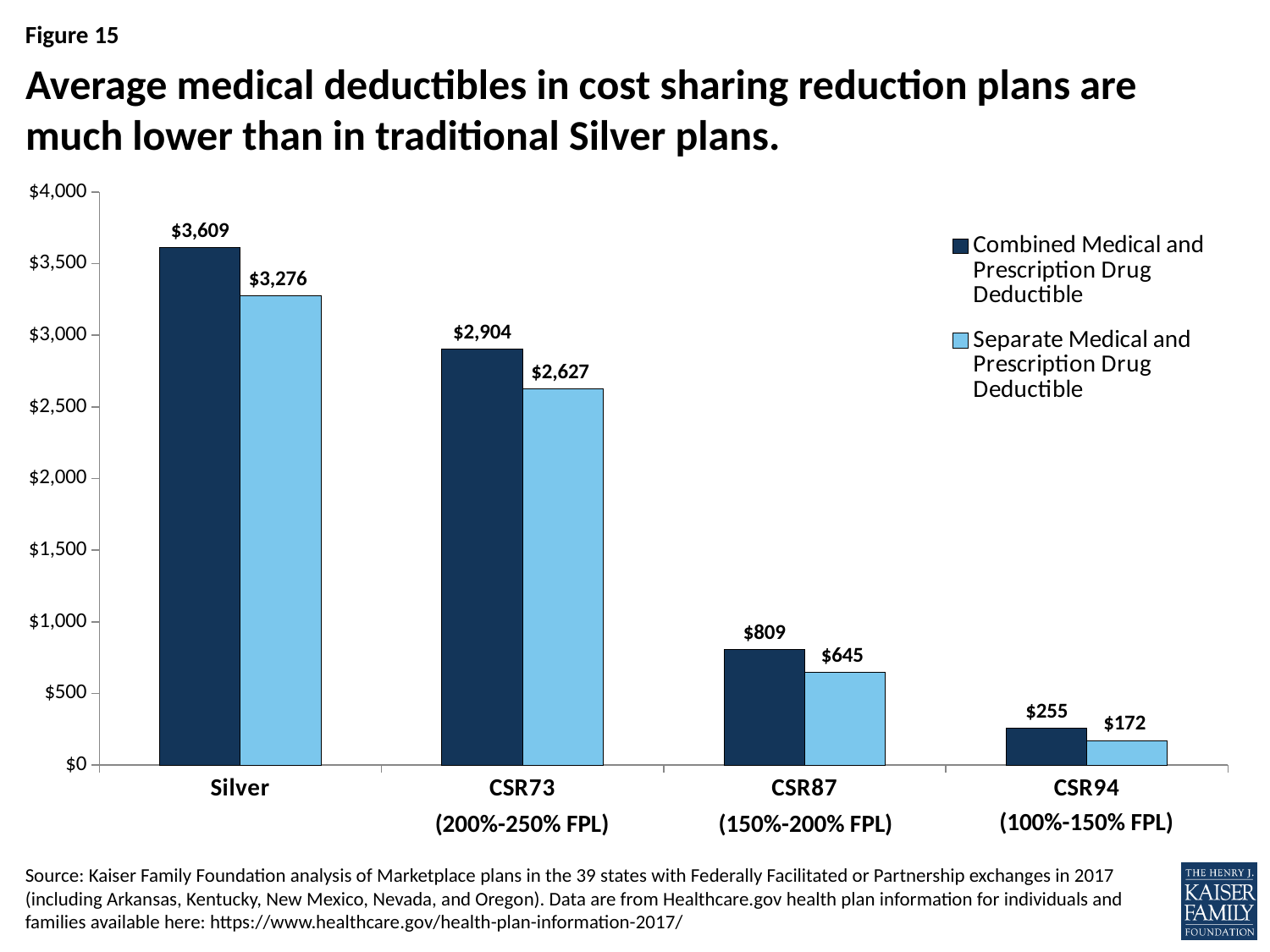
How many series does the legend list? 2 Which is larger for Silver plans: the Combined deductible or the Separate deductible? Combined Medical and Prescription Drug Deductible Which plan type has the lowest Separate Medical and Prescription Drug Deductible? CSR94 Do the Combined deductible values rise or fall moving from Silver to CSR94 along the x axis? Fall What is the Separate Medical and Prescription Drug Deductible for CSR87 plans? $645 What is the difference between the Combined and Separate deductibles for CSR73 plans? $277 How many plan types are shown on the x axis? 4 What kind of chart is shown on the slide? Bar chart What is the Combined Medical and Prescription Drug Deductible for CSR94 plans? $255 What is the Combined Medical and Prescription Drug Deductible for Silver plans? $3,609 Is the Combined Medical and Prescription Drug Deductible for CSR87 greater or less than $1,000? less Which plan type has the highest Combined Medical and Prescription Drug Deductible? Silver